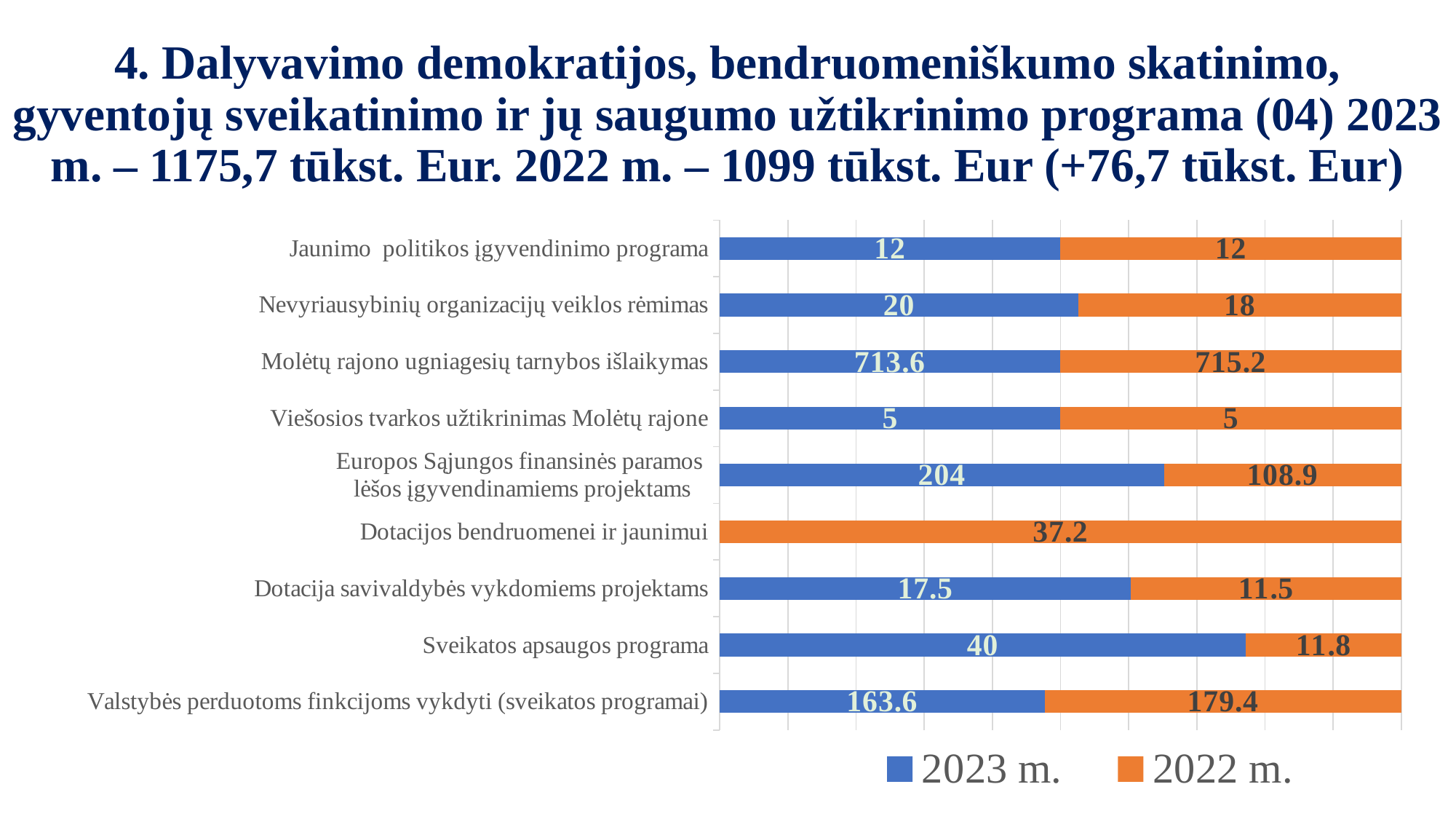
What is the 2022 m. value for Dotacijos bendruomenei ir jaunimui? 37.2 What is the combined total of the 2023 m. and 2022 m. values for Sveikatos apsaugos programa? 51.8 Which is larger for Valstybės perduotoms finkcijoms vykdyti (sveikatos programai): the 2023 m. value or the 2022 m. value? 2022 m. How many categories are shown on the chart? 9 How many series does the legend list? 2 Which category has the highest 2023 m. value? Molėtų rajono ugniagesių tarnybos išlaikymas What is the 2023 m. value for Sveikatos apsaugos programa? 40 What is the difference between the 2023 m. and 2022 m. values for Europos Sąjungos finansinės paramos lėšos įgyvendinamiems projektams? 95.1 Which category has the lowest 2022 m. value? Viešosios tvarkos užtikrinimas Molėtų rajone Which colour represents the 2022 m. series in the legend? Orange What is the 2022 m. value for Molėtų rajono ugniagesių tarnybos išlaikymas? 715.2 What kind of chart is shown on the slide? Stacked bar chart